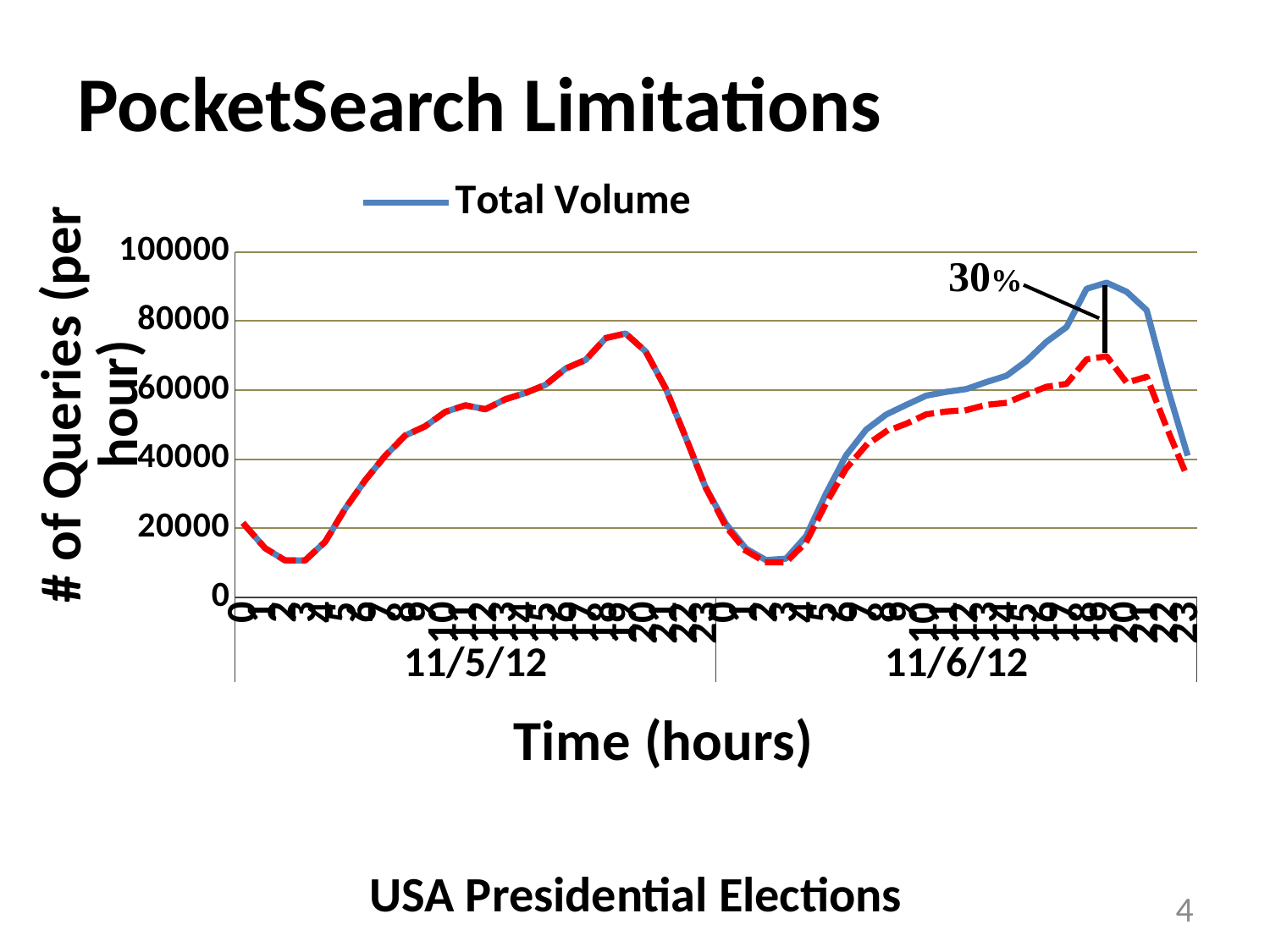
Is the lowest value of the Total Volume line at the start of 11/6/12 greater or less than 20000? less Is the peak value of the Total Volume line on 11/5/12 greater or less than 80000? less What percentage is annotated near the peak of the Total Volume line on 11/6/12? 30% What is the title of the vertical axis? # of Queries (per hour) After the peak on 11/5/12, does the Total Volume line rise or fall toward the start of 11/6/12? fall Is the first value of the Total Volume line on 11/5/12 greater or less than 40000? less What is the highest value shown on the vertical axis? 100000 What kind of chart is shown on the slide? line chart What series name appears in the chart legend? Total Volume Which day shows the higher peak of the Total Volume line, 11/5/12 or 11/6/12? 11/6/12 How many series does the chart legend list? 1